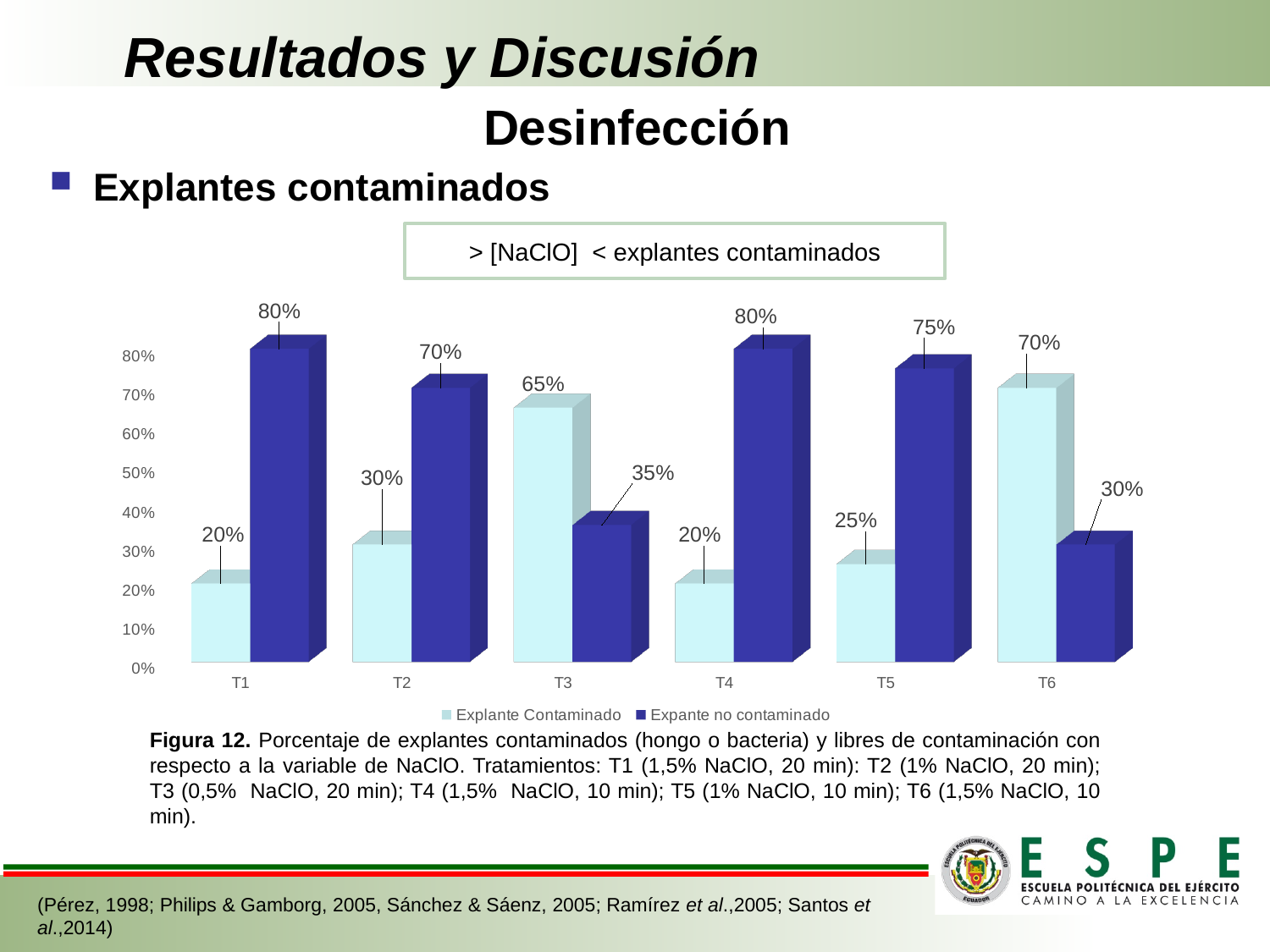
How many series does the legend list? 2 At T3, which is larger: Explante Contaminado or Expante no contaminado? Explante Contaminado What is the value for Explante Contaminado at T3? 65% Which treatment has the lowest value for Expante no contaminado? T6 What is the value for Explante Contaminado at T2? 30% What is the difference between Expante no contaminado and Explante Contaminado at T1? 60% What kind of chart is shown on the slide? Bar chart What is the value for Expante no contaminado at T5? 75% What is the value for Expante no contaminado at T6? 30% What is the total of Explante Contaminado and Expante no contaminado at T4? 100% Which treatment has the highest value for Explante Contaminado? T6 How many treatments are shown on the x axis? 6